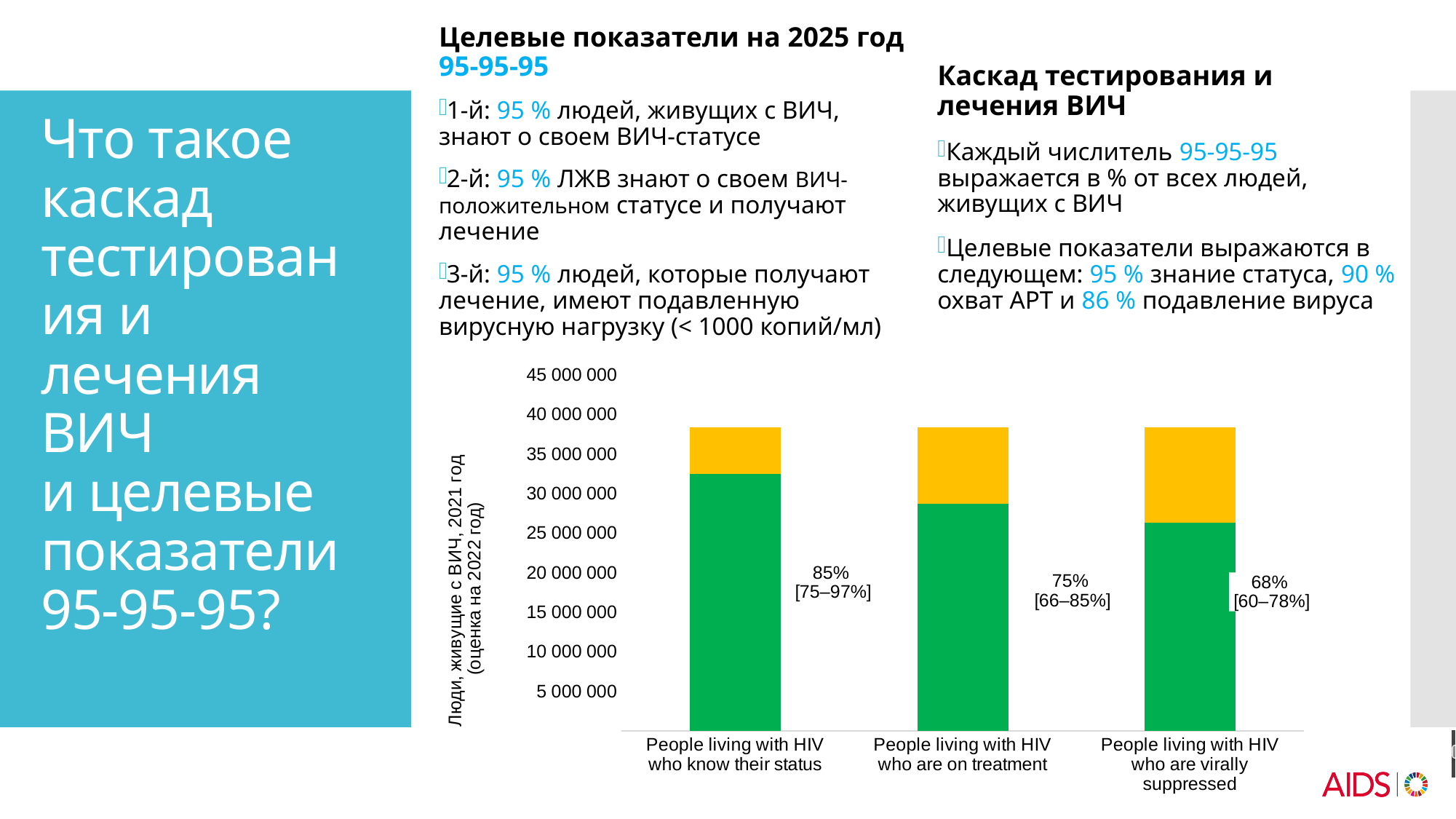
Do the percentage labels rise or fall from left to right across the categories? Fall What percentage is shown for People living with HIV who know their status? 85% What percentage is shown for People living with HIV who are on treatment? 75% Which is larger: the percentage for people on treatment or the percentage for people virally suppressed? People living with HIV who are on treatment How many categories are shown on the x axis of the chart? 3 Which category has the lowest percentage label? People living with HIV who are virally suppressed What range is given in brackets under the 68% label? [60–78%] What is the difference in percentage points between the label for people who know their status and the label for people on treatment? 10 Is the green segment for People living with HIV who know their status greater or less than 30 000 000? greater What kind of chart is shown on the slide? Stacked bar chart Which category has the highest percentage label? People living with HIV who know their status What percentage is shown for People living with HIV who are virally suppressed? 68%